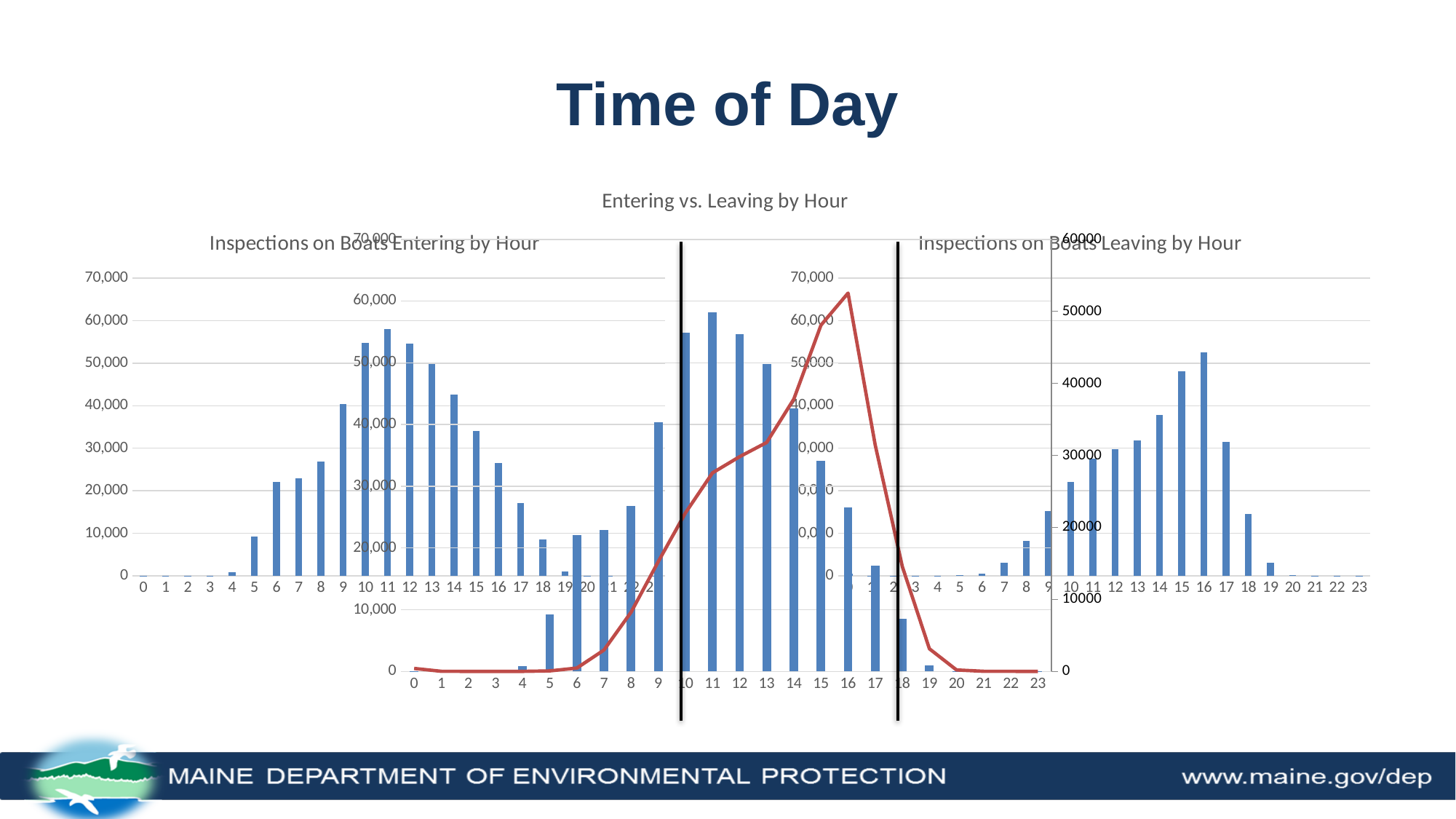
On the 'Inspections on Boats Entering by Hour' chart, which is larger, the value for hour 9 or the value for hour 15? hour 9 On the 'Inspections on Boats Entering by Hour' chart, do the values rise or fall from hour 11 to hour 17? fall How many hour categories are shown on the x axis of the 'Inspections on Boats Entering by Hour' chart? 24 On the 'Inspections on Boats Entering by Hour' chart, is the value for hour 14 greater or less than 40,000? greater What kind of chart is 'Inspections on Boats Leaving by Hour'? bar chart On the 'Inspections on Boats Entering by Hour' chart, which hour has the highest value? 11 On the 'Inspections on Boats Leaving by Hour' chart, is the value for hour 10 greater or less than 30000? less On the 'Inspections on Boats Leaving by Hour' chart, which hour has the highest value? 16 On the 'Inspections on Boats Entering by Hour' chart, is the value for hour 8 greater or less than 20,000? greater